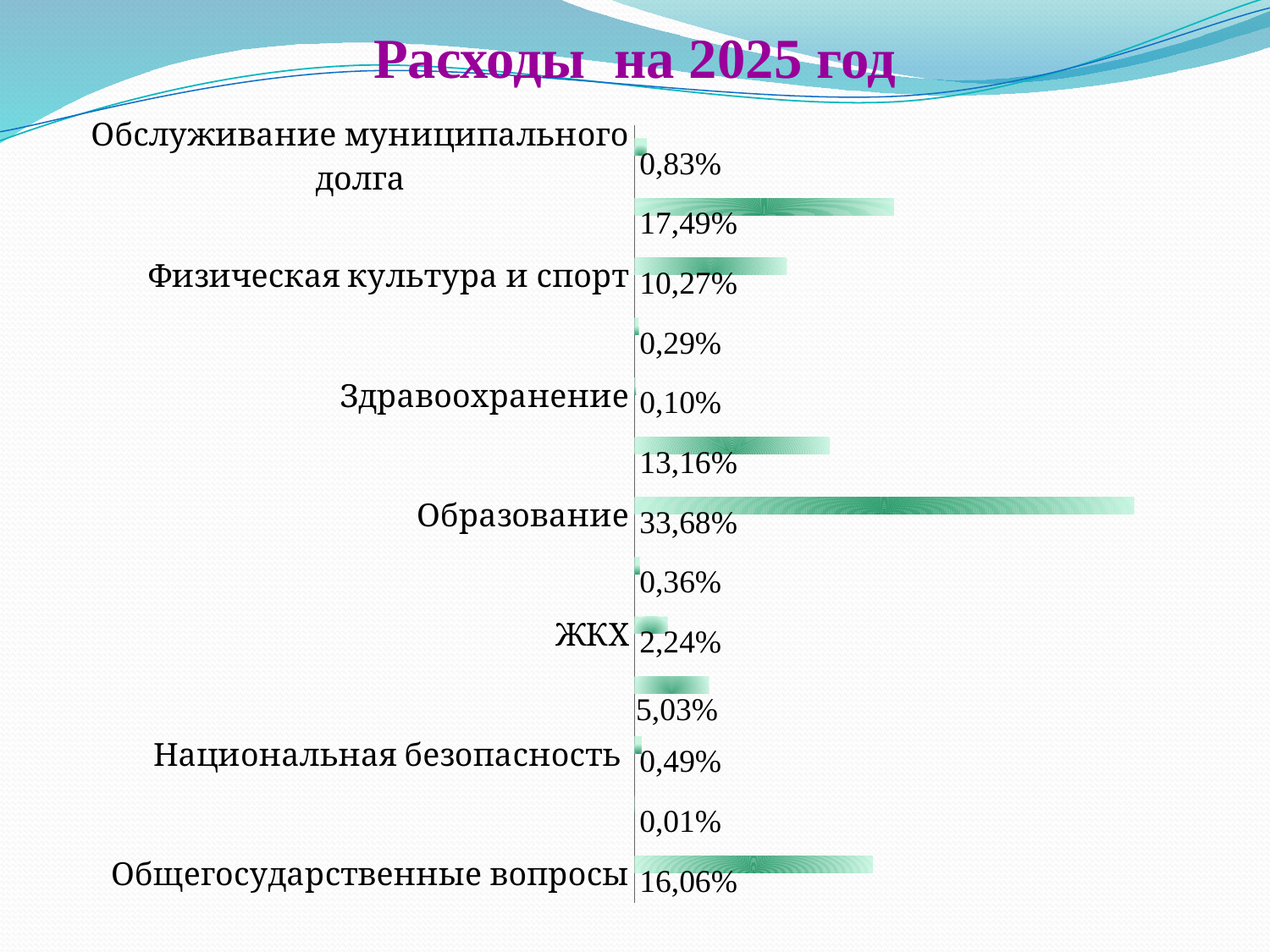
What is the value for Обслуживание муниципального долга? 0,83% What is the value for Здравоохранение? 0,10% What is the value for Образование? 33,68% What is the smallest value shown on the chart? 0,01% What is the difference between the values for Образование and Общегосударственные вопросы? 17,62% Which is larger, the value for Физическая культура и спорт or the value for Общегосударственные вопросы? Общегосударственные вопросы What is the value for ЖКХ? 2,24% What is the value for Общегосударственные вопросы? 16,06% What kind of chart is shown on the slide? bar chart Which category has the highest value? Образование What is the value for Физическая культура и спорт? 10,27% What is the title of the chart? Расходы на 2025 год